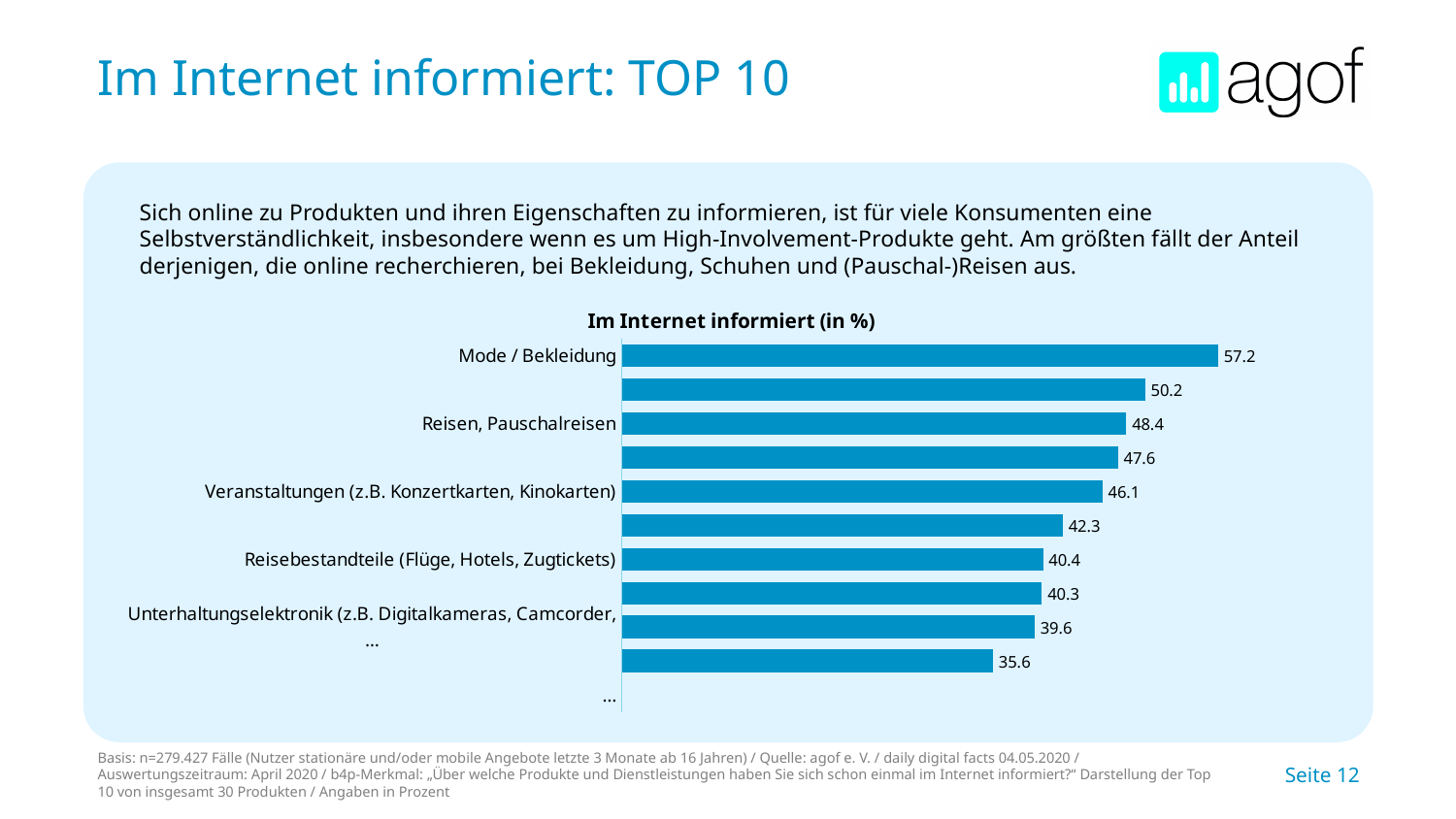
What is the value for Reisen, Pauschalreisen? 48.4 What is the title of the chart? Im Internet informiert (in %) What is the lowest value shown in the chart? 35.6 What is the difference between the values for Mode / Bekleidung and Reisen, Pauschalreisen? 8.8 How many bars are plotted in the chart? 10 Do the values increase or decrease from the top bar to the bottom bar? Decrease What kind of chart is shown on the slide? Bar chart Which category has the highest value? Mode / Bekleidung What is the value for Veranstaltungen (z.B. Konzertkarten, Kinokarten)? 46.1 What is the value for Mode / Bekleidung? 57.2 What is the value for Reisebestandteile (Flüge, Hotels, Zugtickets)? 40.4 Which is larger, the value for Veranstaltungen (z.B. Konzertkarten, Kinokarten) or the value for Reisebestandteile (Flüge, Hotels, Zugtickets)? Veranstaltungen (z.B. Konzertkarten, Kinokarten)